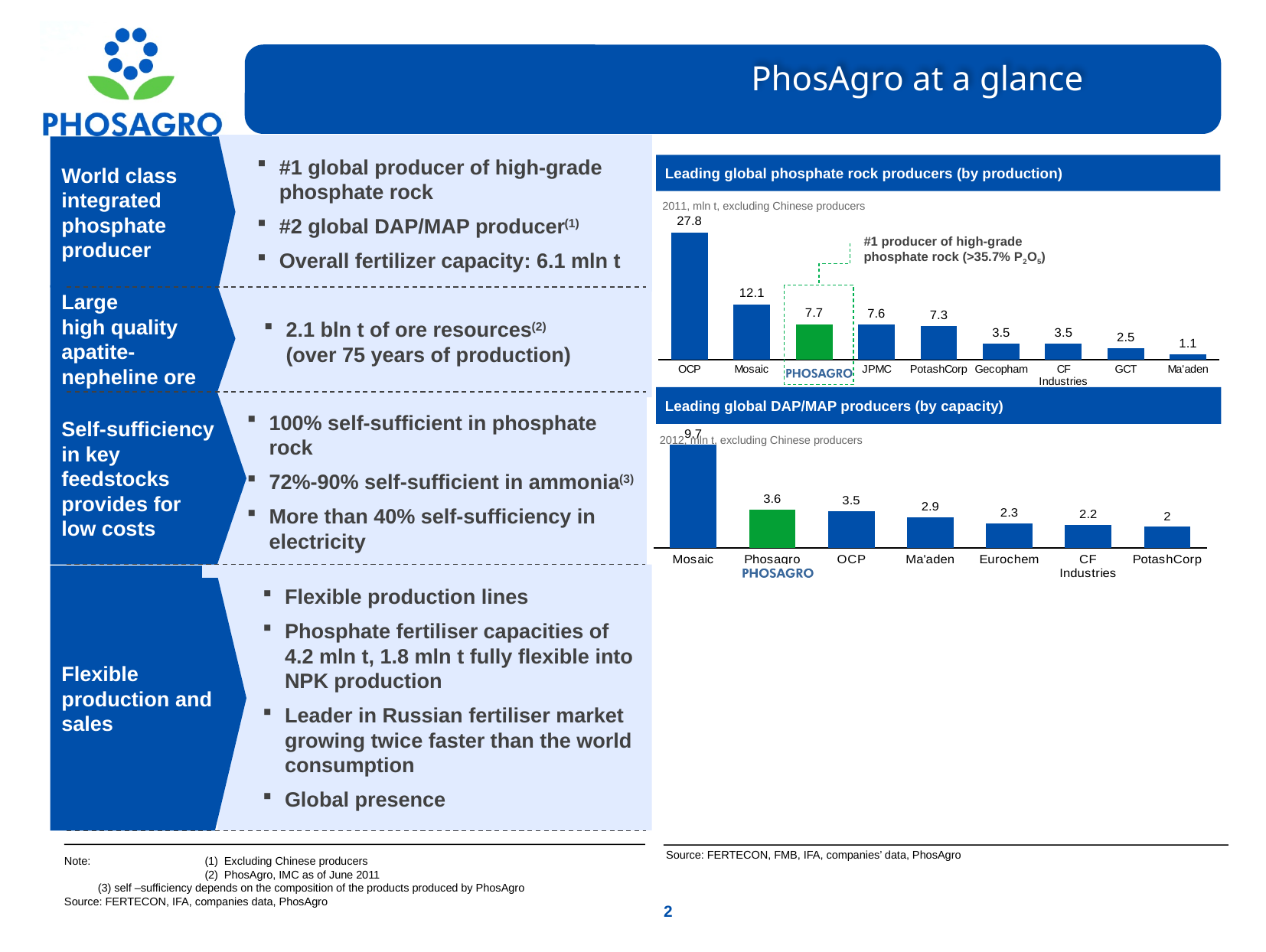
In the 'Leading global DAP/MAP producers (by capacity)' chart, what is the difference between Mosaic and PotashCorp? 7.7 In the 'Leading global DAP/MAP producers (by capacity)' chart, which producer has the highest value? Mosaic In the 'Leading global DAP/MAP producers (by capacity)' chart, how many producers are shown? 7 In the 'Leading global phosphate rock producers (by production)' chart, which producer has the lowest value? Ma'aden What type of chart is the 'Leading global DAP/MAP producers (by capacity)' chart? Bar chart In the 'Leading global DAP/MAP producers (by capacity)' chart, what is the value for Eurochem? 2.3 In the 'Leading global phosphate rock producers (by production)' chart, what is the value for OCP? 27.8 In the 'Leading global phosphate rock producers (by production)' chart, how many producers are shown? 9 In the 'Leading global phosphate rock producers (by production)' chart, what is the value for PhosAgro? 7.7 In the 'Leading global phosphate rock producers (by production)' chart, what is the difference between OCP and Mosaic? 15.7 In the 'Leading global phosphate rock producers (by production)' chart, what is the value for GCT? 2.5 In the 'Leading global DAP/MAP producers (by capacity)' chart, what is the value for PhosAgro? 3.6